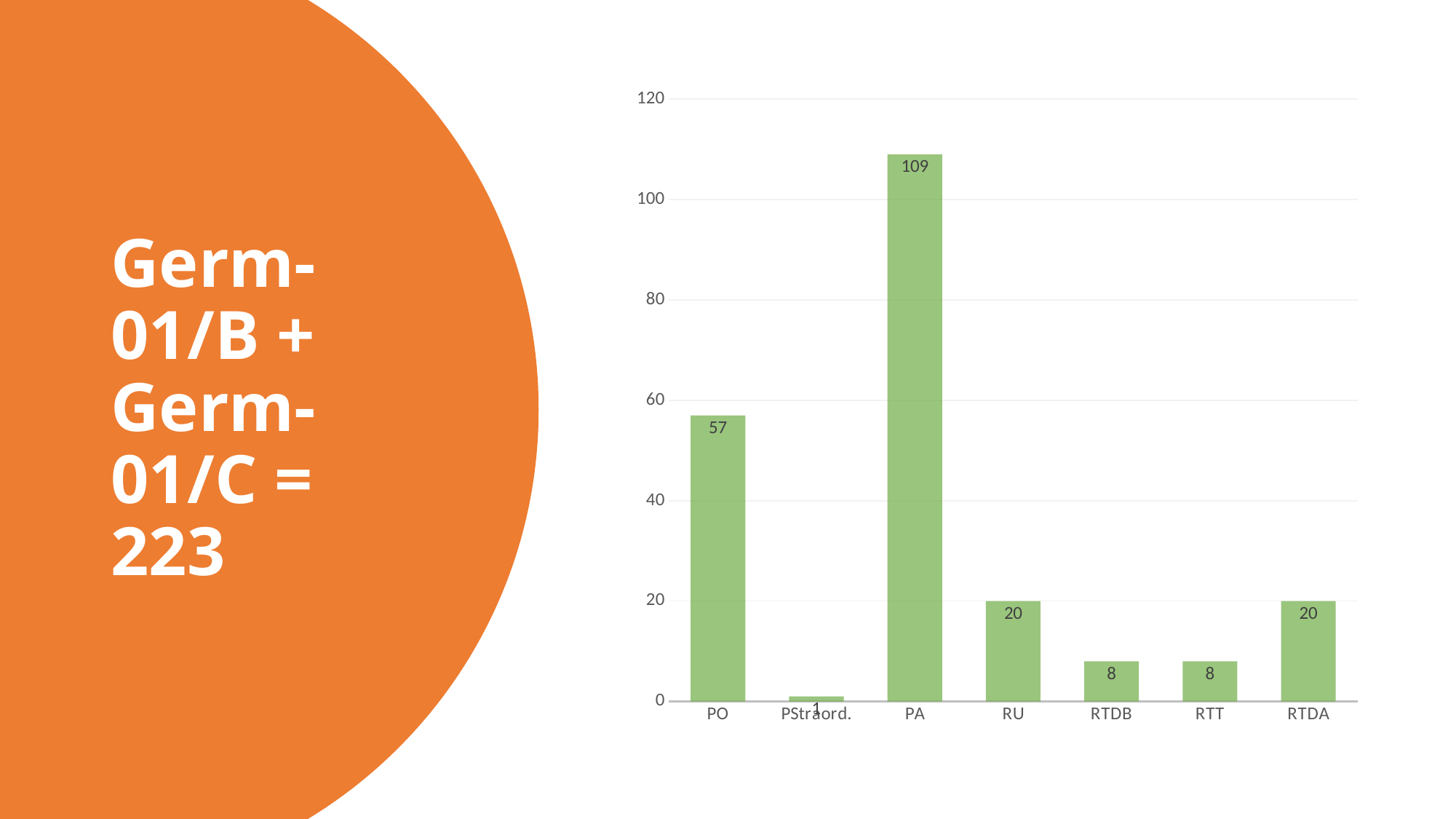
What is the value for RU? 20 What is the value for PO? 57 What is the difference between the values for PA and PO? 52 What colour are the bars in the chart? Green How many categories are shown on the x axis? 7 What kind of chart is shown on the slide? Bar chart Which is larger, the value for PO or the value for RU? PO Which category has the highest value? PA What is the value for RTDB? 8 Is the value for PA greater or less than 100? greater Which category has the lowest value? PStraord. What is the value for PA? 109